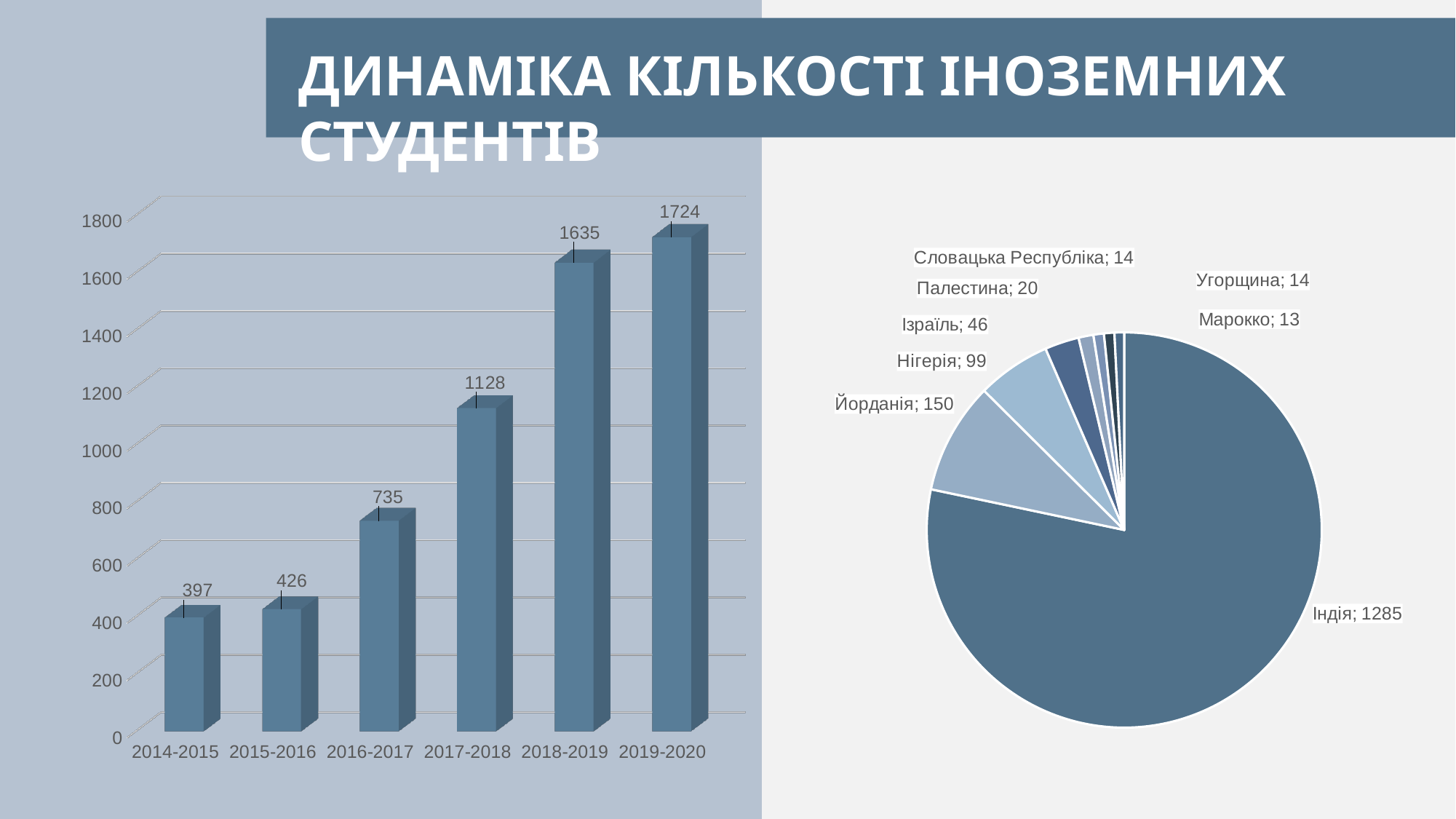
In the pie chart on the right, which is larger, the value for Нігерія or the value for Ізраїль? Нігерія What kind of chart is shown on the left side of the slide? bar chart In the pie chart on the right, how many slices are labelled? 8 In the bar chart on the left, what is the difference between the values for 2019-2020 and 2018-2019? 89 In the pie chart on the right, which country has the largest slice? Індія In the bar chart on the left, which academic year has the highest value? 2019-2020 In the bar chart on the left, which academic year has the lowest value? 2014-2015 In the pie chart on the right, what is the value for Йорданія? 150 In the bar chart on the left, what is the value for 2014-2015? 397 In the bar chart on the left, how many academic years are shown on the x axis? 6 In the bar chart on the left, what is the value for 2017-2018? 1128 In the bar chart on the left, do the values rise or fall from 2014-2015 to 2019-2020? rise